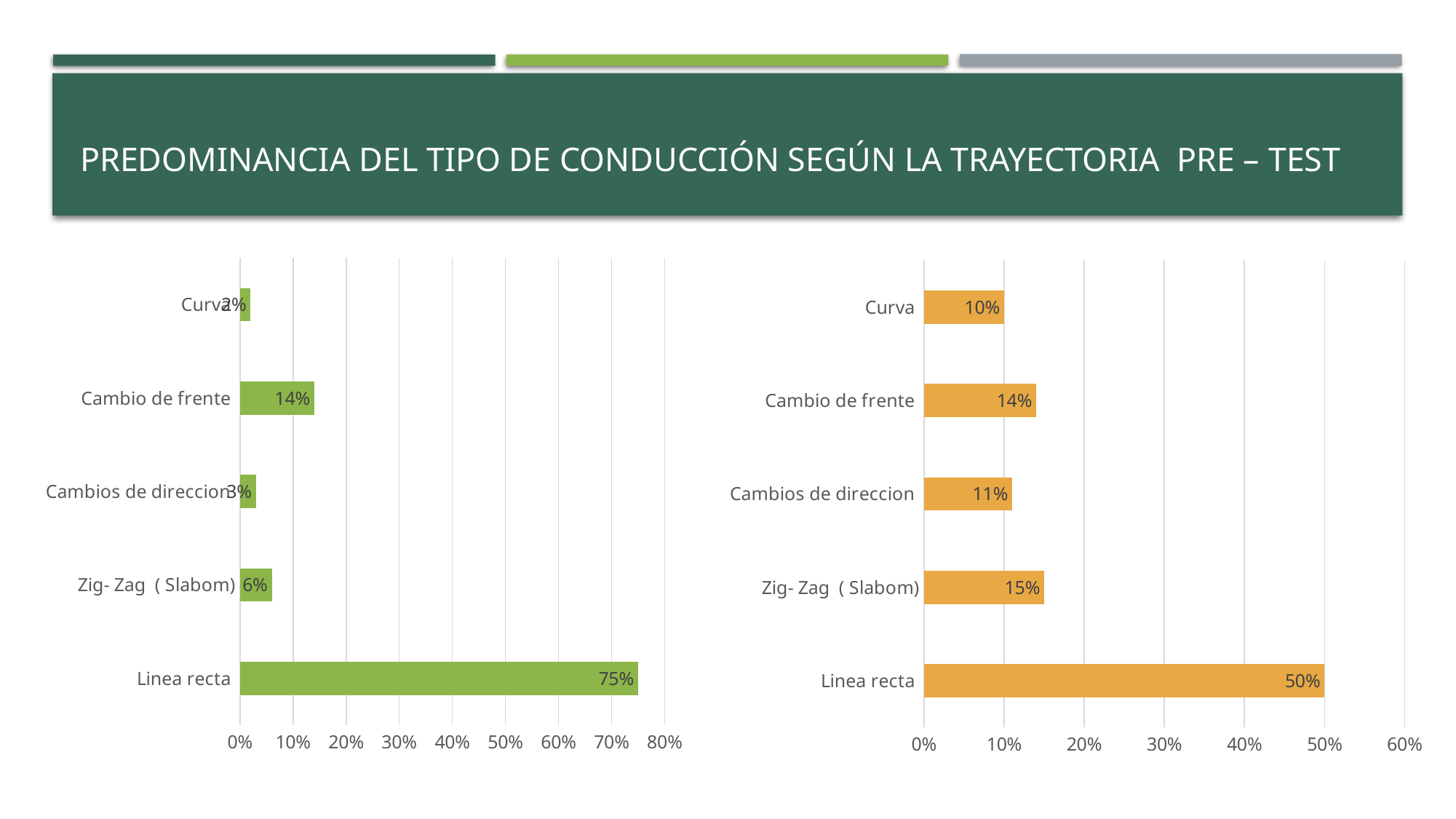
On the left chart, is the value for Zig- Zag ( Slabom) greater or less than 10%? less On the right chart, which category has the lowest value? Curva On the right chart, what is the value for Zig- Zag ( Slabom)? 15% On the left chart, which category has the highest value? Linea recta On the right chart, what is the difference between Linea recta and Zig- Zag ( Slabom)? 35% On the right chart, what is the value for Curva? 10% How many categories does the right chart show? 5 On the left chart, what is the value for Cambio de frente? 14% On the right chart, which is larger, Cambios de direccion or Cambio de frente? Cambio de frente On the left chart, what is the value for Linea recta? 75% On the right chart, what is the value for Linea recta? 50% What kind of chart is the left chart? bar chart